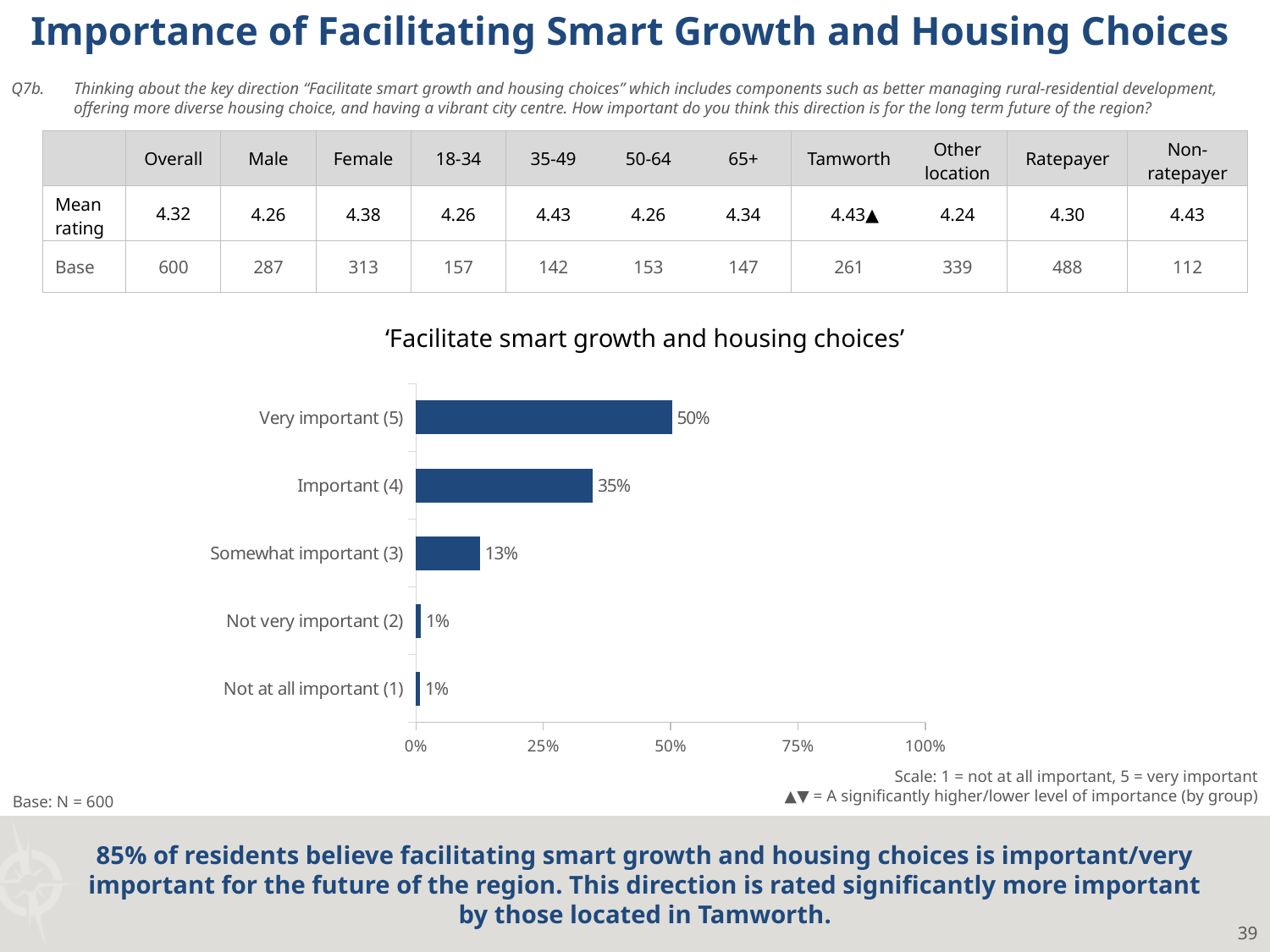
What is the difference in percentage points between 'Important (4)' and 'Somewhat important (3)'? 22 What percentage of respondents rated the direction as 'Very important (5)'? 50% Which is larger, the percentage for 'Important (4)' or for 'Somewhat important (3)'? Important (4) What percentage of respondents rated the direction as 'Not very important (2)'? 1% What is the title of the chart? 'Facilitate smart growth and housing choices' What is the difference in percentage points between 'Very important (5)' and 'Important (4)'? 15 How many rating categories are shown in the chart? 5 What percentage of respondents rated the direction as 'Somewhat important (3)'? 13% Is the value for 'Very important (5)' greater or less than 25%? greater What percentage of respondents rated the direction as 'Important (4)'? 35% Which rating category has the highest percentage? Very important (5) What type of chart is shown on the slide? Bar chart